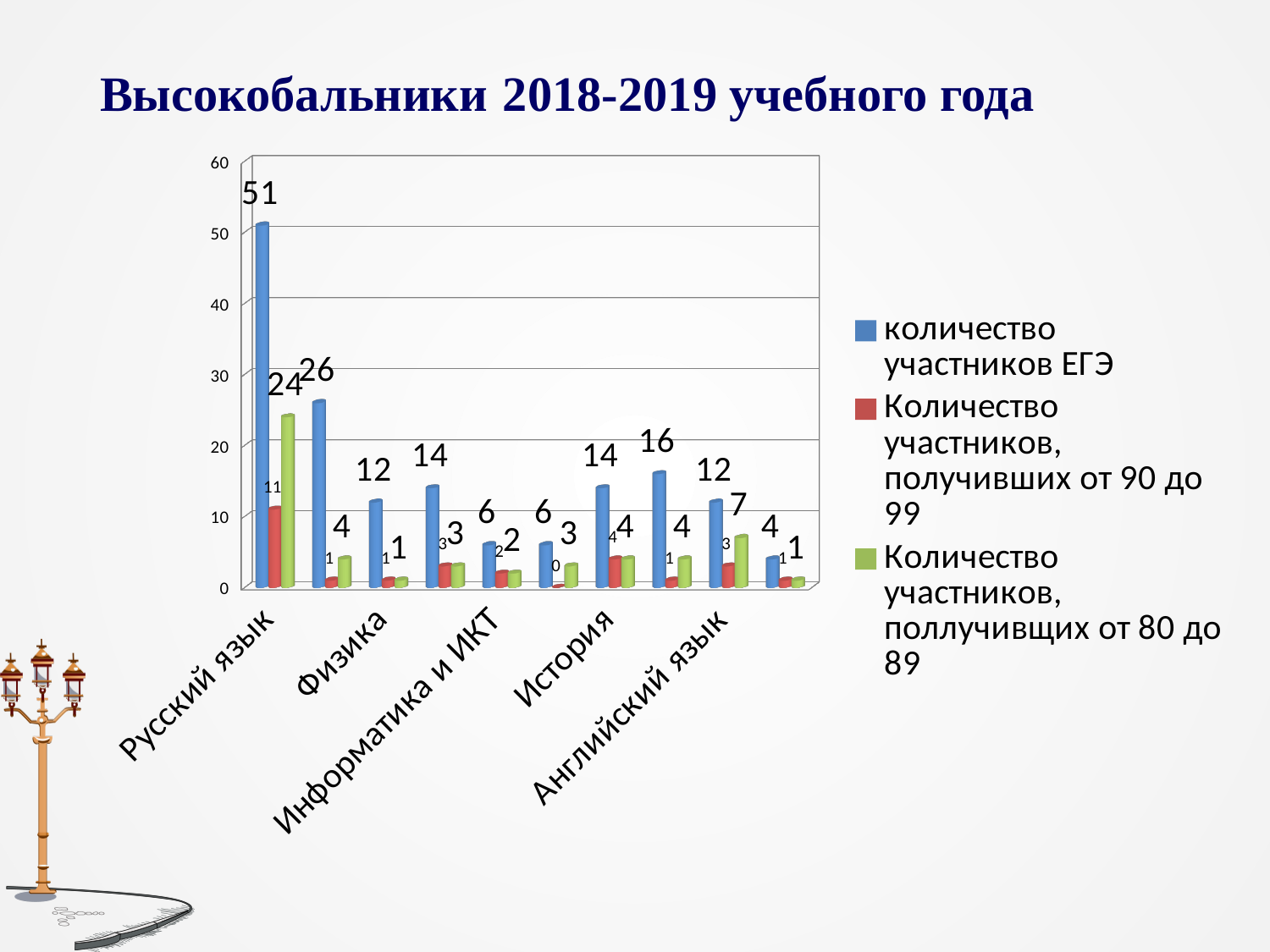
Which has more participants scoring from 80 to 89: Русский язык or История? Русский язык How many participants scored from 80 to 89 in Русский язык? 24 How many series does the legend list? 3 What kind of chart is shown on the slide? Bar chart How many participants scored from 90 to 99 in Русский язык? 11 What is the number of ЕГЭ participants (количество участников ЕГЭ) for Русский язык? 51 What is the difference between the number of ЕГЭ participants and the number scoring 80 to 89 for Русский язык? 27 Which subject has the highest number of ЕГЭ participants? Русский язык What is the title of the slide? Высокобальники 2018-2019 учебного года What is the number of ЕГЭ participants for Физика? 12 How many participants scored from 80 to 89 in Английский язык? 7 What is the number of ЕГЭ participants for История? 14